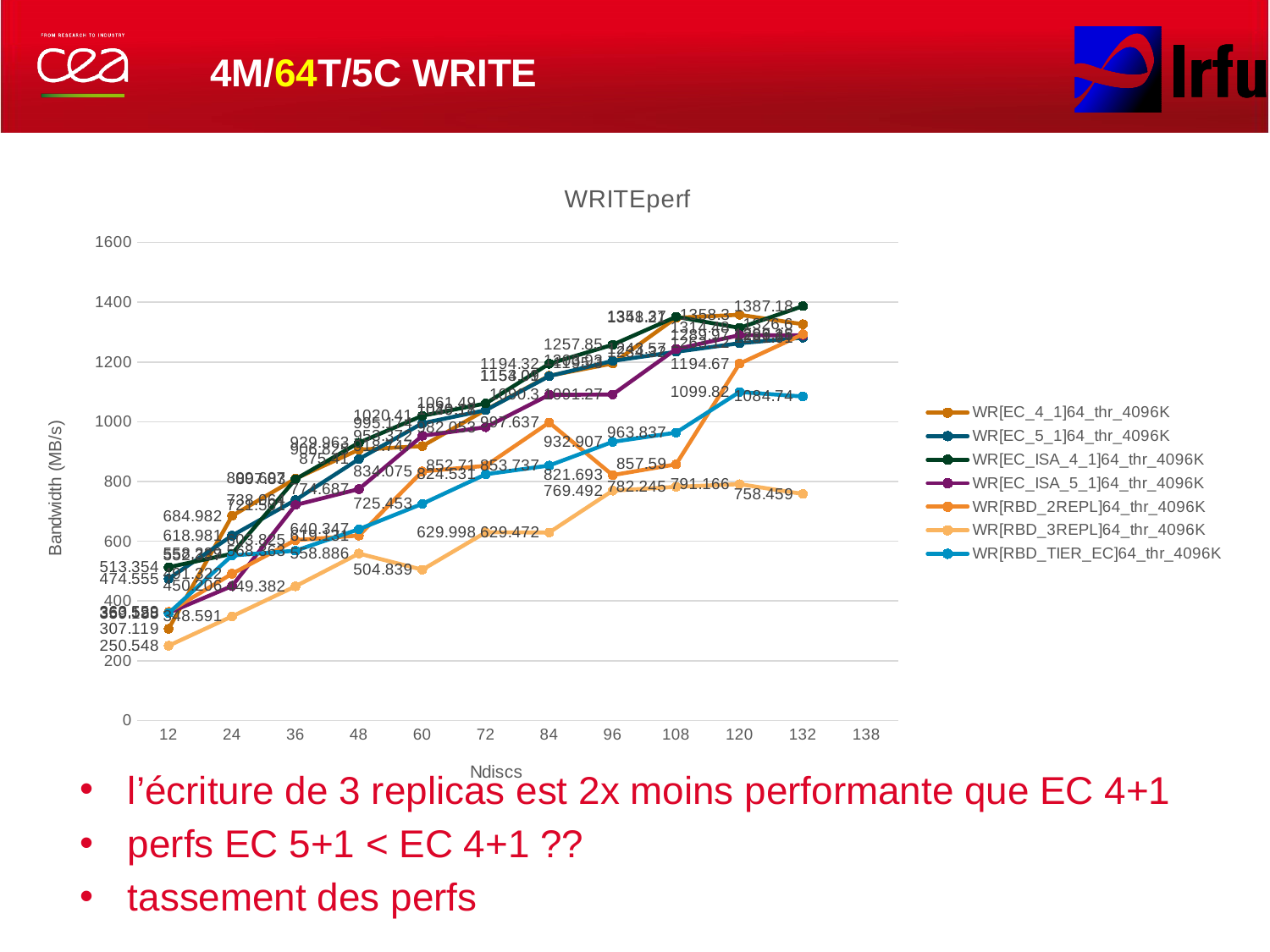
Which series has the highest value at 132 discs? WR[EC_ISA_4_1]64_thr_4096K Does the WR[EC_ISA_4_1]64_thr_4096K series generally rise or fall as the number of discs increases? rise Which series has the lowest value at 12 discs? WR[RBD_3REPL]64_thr_4096K What is the title of the chart? WRITEperf What type of chart is shown on the slide? line chart What is the value of WR[EC_ISA_4_1]64_thr_4096K at 132 discs? 1387.18 Is the value for WR[RBD_TIER_EC]64_thr_4096K at 132 discs greater or less than 1000? greater What is the value of WR[RBD_3REPL]64_thr_4096K at 12 discs? 250.548 How many series does the legend list? 7 What is the value of WR[RBD_3REPL]64_thr_4096K at 132 discs? 758.459 What is the difference between WR[EC_ISA_4_1]64_thr_4096K and WR[RBD_3REPL]64_thr_4096K at 132 discs? 628.721 What is the y-axis label of the chart? Bandwidth (MB/s)